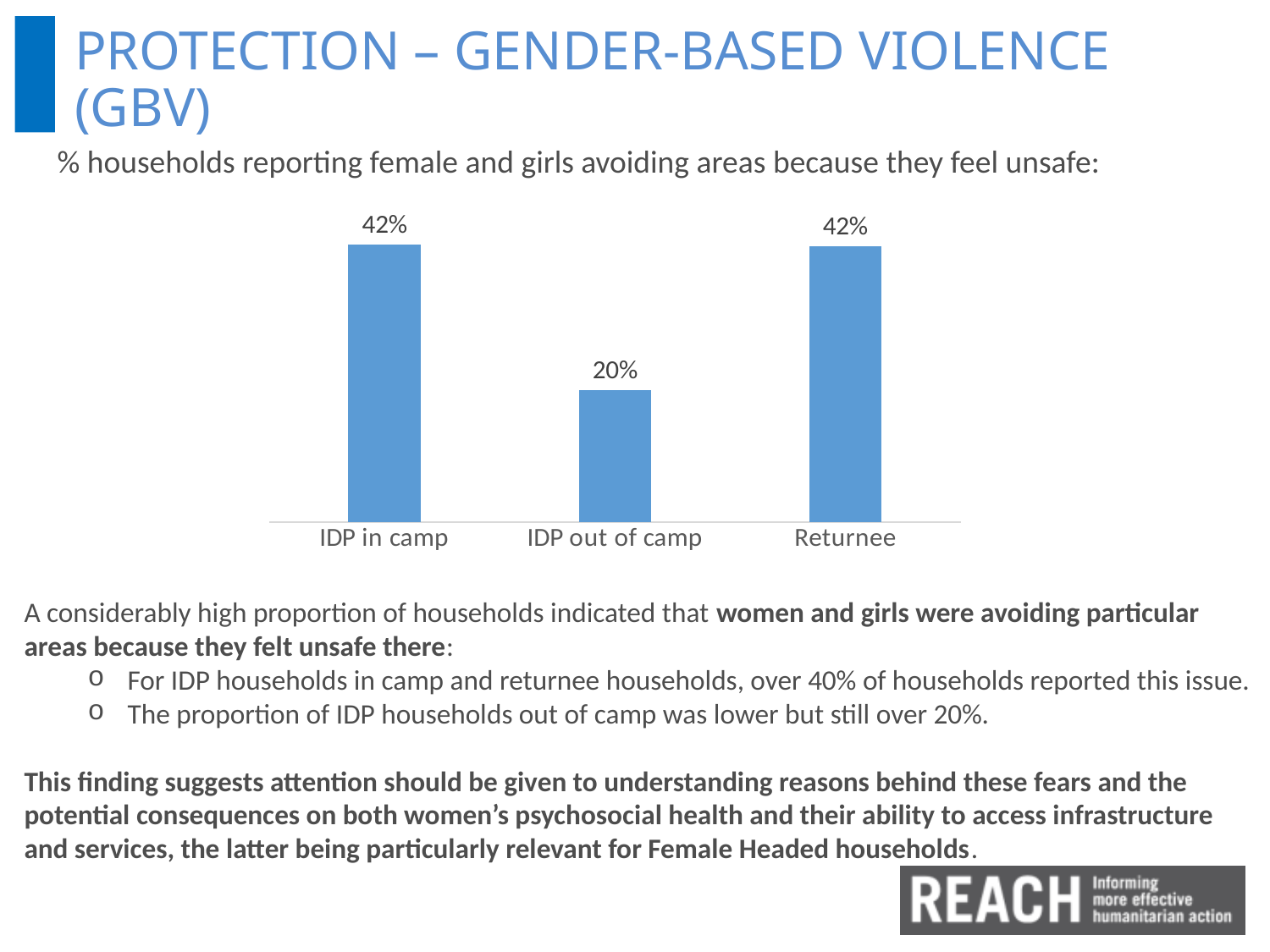
What is the value for IDP out of camp? 20% Do IDP in camp and Returnee households have the same value? Yes, both 42% What is the difference between the values for Returnee and IDP out of camp? 22 percentage points What is the value for Returnee households? 42% What colour are the bars in the chart? Blue What percentage of IDP in camp households reported female and girls avoiding areas because they feel unsafe? 42% What is the difference between the values for IDP in camp and IDP out of camp? 22 percentage points What kind of chart is shown on the slide? Bar chart Which is larger, the value for Returnee or the value for IDP out of camp? Returnee How many categories are shown on the x axis? 3 What does the chart measure, according to the text above it? % households reporting female and girls avoiding areas because they feel unsafe Which category has the lowest value? IDP out of camp